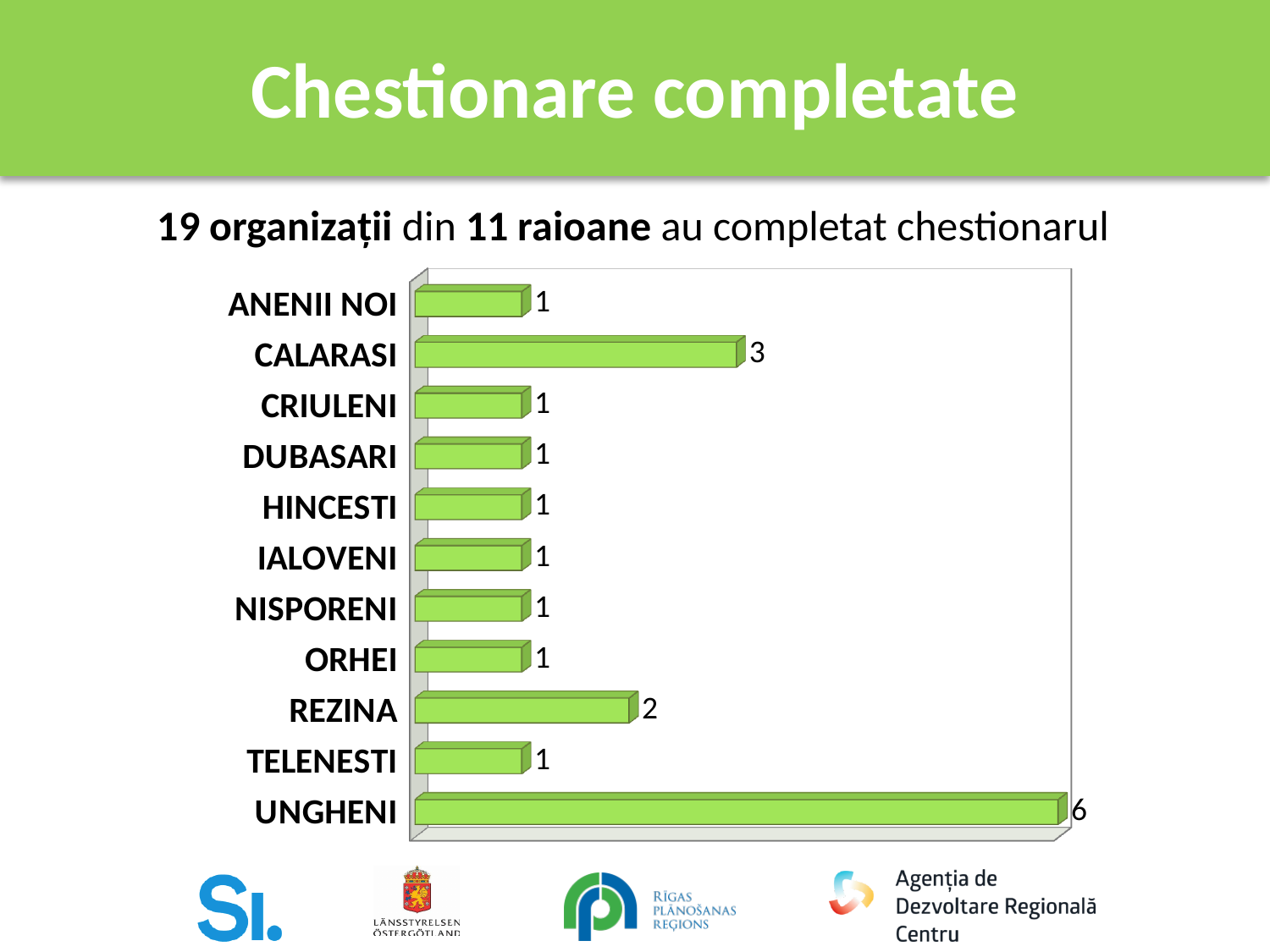
How many categories have a value of 1? 8 How many categories are shown in the chart? 11 What is the difference between the values for CALARASI and REZINA? 1 What is the value for ORHEI? 1 What is the value for CALARASI? 3 Which is larger, the value for REZINA or the value for HINCESTI? REZINA What kind of chart is shown on the slide? bar chart Which is larger, the value for CALARASI or the value for UNGHENI? UNGHENI What is the difference between the values for UNGHENI and CALARASI? 3 What is the value for REZINA? 2 Which category has the highest value? UNGHENI What is the value for UNGHENI? 6